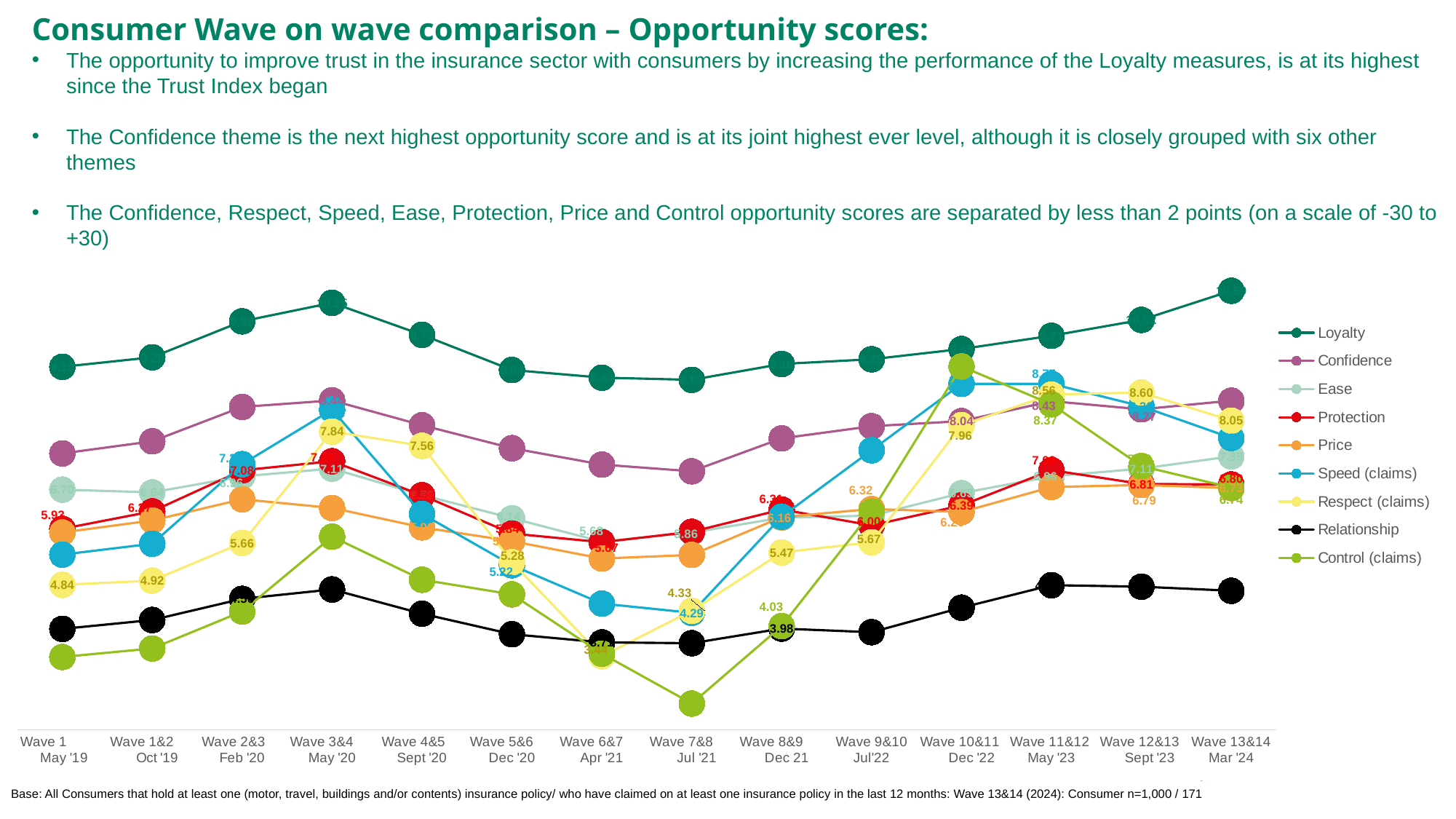
Which series has the highest value at Wave 13&14 Mar '24? Loyalty By how much did the Respect (claims) value fall from Wave 12&13 Sept '23 (8.60) to Wave 13&14 Mar '24 (8.05)? 0.55 Which series is drawn in black? Relationship What is the Respect (claims) value at Wave 12&13 Sept '23? 8.60 What is the Respect (claims) value at Wave 1 May '19? 4.84 How many series does the legend list? 9 What is the Speed (claims) value at Wave 7&8 Jul '21? 4.29 Which is larger at Wave 3&4 May '20, the Loyalty value or the Relationship value? Loyalty What type of chart is shown on the slide? Line chart How many wave periods are shown along the x axis? 14 Which series has the lowest value at Wave 7&8 Jul '21? Control (claims)